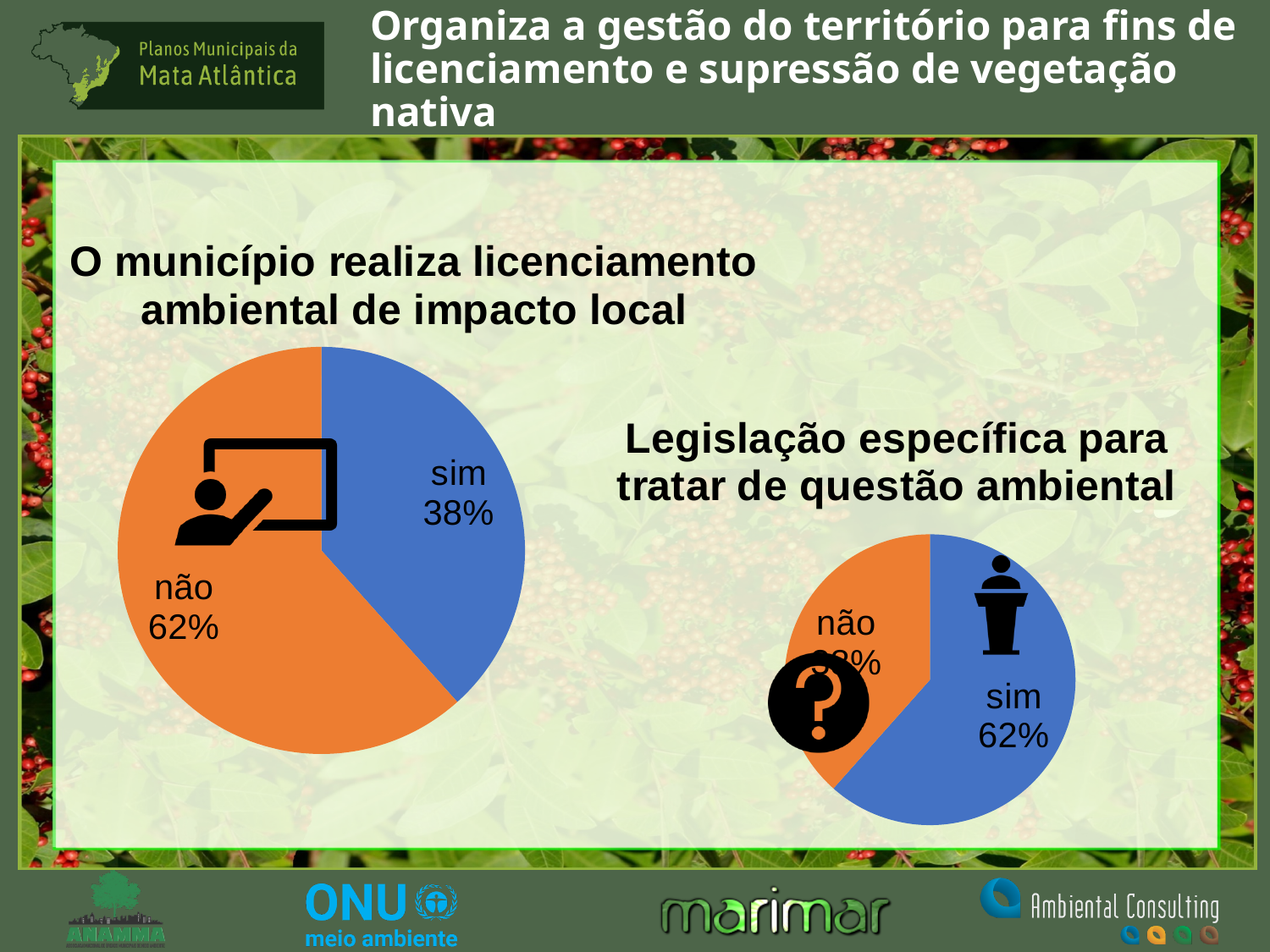
In the chart titled "Legislação específica para tratar de questão ambiental", what percentage is shown for "sim"? 62% In the chart titled "O município realiza licenciamento ambiental de impacto local", what percentage is shown for "não"? 62% In the chart titled "O município realiza licenciamento ambiental de impacto local", which slice is the largest? não In the chart titled "O município realiza licenciamento ambiental de impacto local", what colour is the "sim" slice? blue How many slices does the chart titled "Legislação específica para tratar de questão ambiental" have? 2 What type of chart is used for "O município realiza licenciamento ambiental de impacto local"? pie chart How many charts are shown on the slide? 2 In the chart titled "Legislação específica para tratar de questão ambiental", which slice is the largest? sim In the chart titled "Legislação específica para tratar de questão ambiental", which slice is larger, "sim" or "não"? sim In the chart titled "O município realiza licenciamento ambiental de impacto local", what is the difference in percentage points between "não" and "sim"? 24 In the chart titled "O município realiza licenciamento ambiental de impacto local", what percentage is shown for "sim"? 38% In the chart titled "O município realiza licenciamento ambiental de impacto local", which slice is the smallest? sim